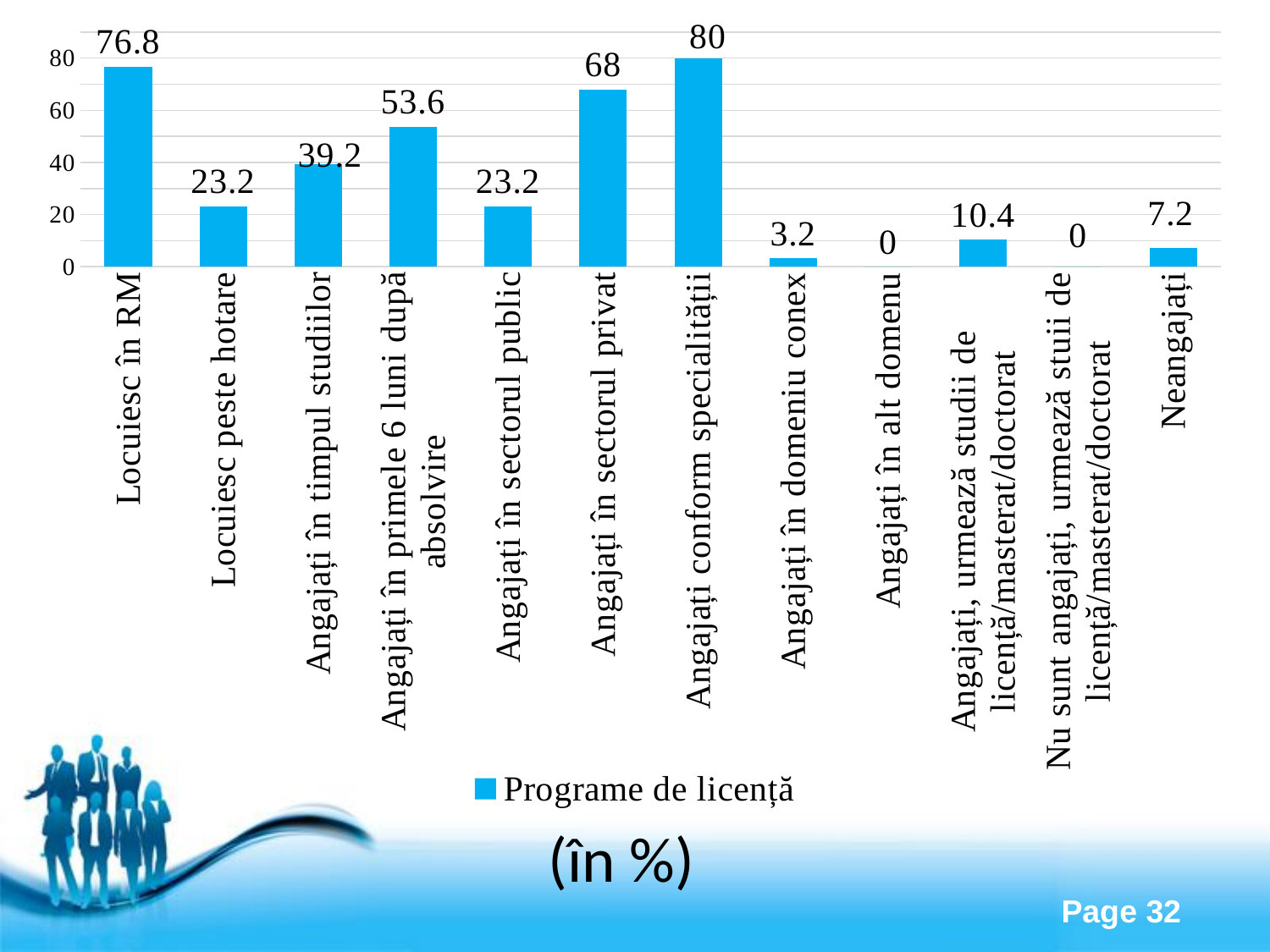
Which is larger, "Angajați în timpul studiilor" or "Angajați în primele 6 luni după absolvire"? Angajați în primele 6 luni după absolvire What is the difference between "Angajați conform specialității" and "Angajați în sectorul privat"? 12 What kind of chart is shown on the slide? Bar chart What is the value for "Neangajați"? 7.2 Which category has the highest value? Angajați conform specialității What is the value for "Angajați în sectorul privat"? 68 What is the difference between "Locuiesc în RM" and "Locuiesc peste hotare"? 53.6 How many series does the legend list? 1 What is the value for "Angajați în domeniu conex"? 3.2 How many categories are shown on the x axis? 12 How many categories have a value of 0? 2 What is the value for "Locuiesc în RM"? 76.8